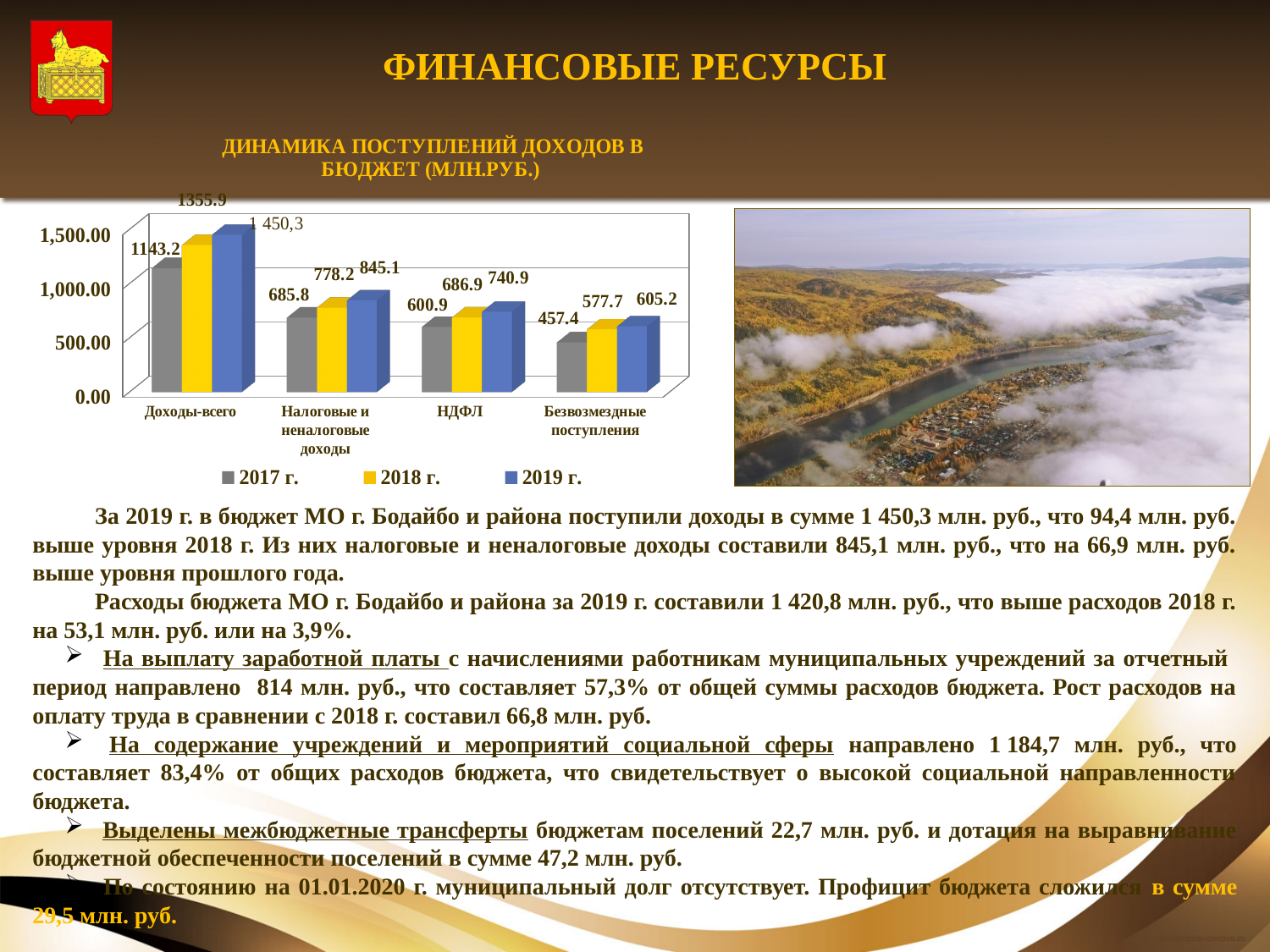
Which category has the lowest value in 2019 г.? Безвозмездные поступления How many series does the chart legend list? 3 How many categories are shown on the x axis of the chart? 4 What is the value for НДФЛ in 2019 г.? 740.9 What is the value for Налоговые и неналоговые доходы in 2018 г.? 778.2 Which is larger: the 2018 г. value for НДФЛ or the 2018 г. value for Безвозмездные поступления? НДФЛ What is the difference between the 2019 г. and 2018 г. values for Налоговые и неналоговые доходы? 66.9 Do the values for Доходы-всего rise or fall from 2017 г. to 2019 г.? rise What type of chart is shown on the slide? bar chart What is the value for Доходы-всего in 2017 г.? 1143.2 What is the value for Безвозмездные поступления in 2017 г.? 457.4 What is the value for Доходы-всего in 2019 г.? 1 450,3